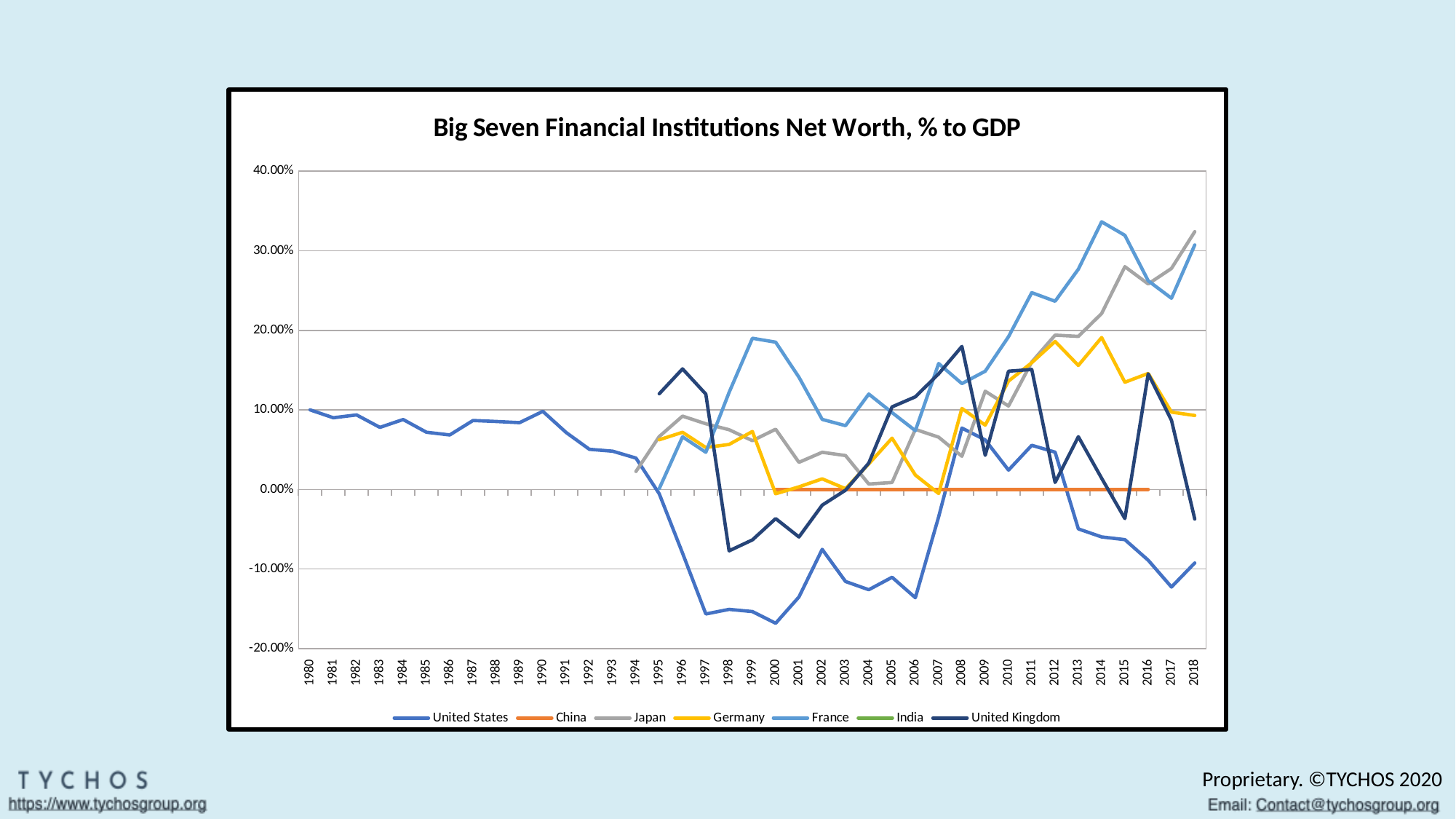
Is the value for Germany in 2014 greater or less than 10.00%? greater Does the United States series rise or fall from 1980 to 1994? fall In 2008, which is higher: the United Kingdom or the United States? United Kingdom Is the value for the United States in 2000 greater or less than -10.00%? less Which series is drawn in orange in the legend? China Is the value for the United Kingdom in 1998 greater or less than 0.00%? less In 2014, which series has the highest value? France How many series does the legend list? 7 What is the title of the chart? Big Seven Financial Institutions Net Worth, % to GDP What kind of chart is shown on the slide? line chart In 2000, which series has the lowest value? United States